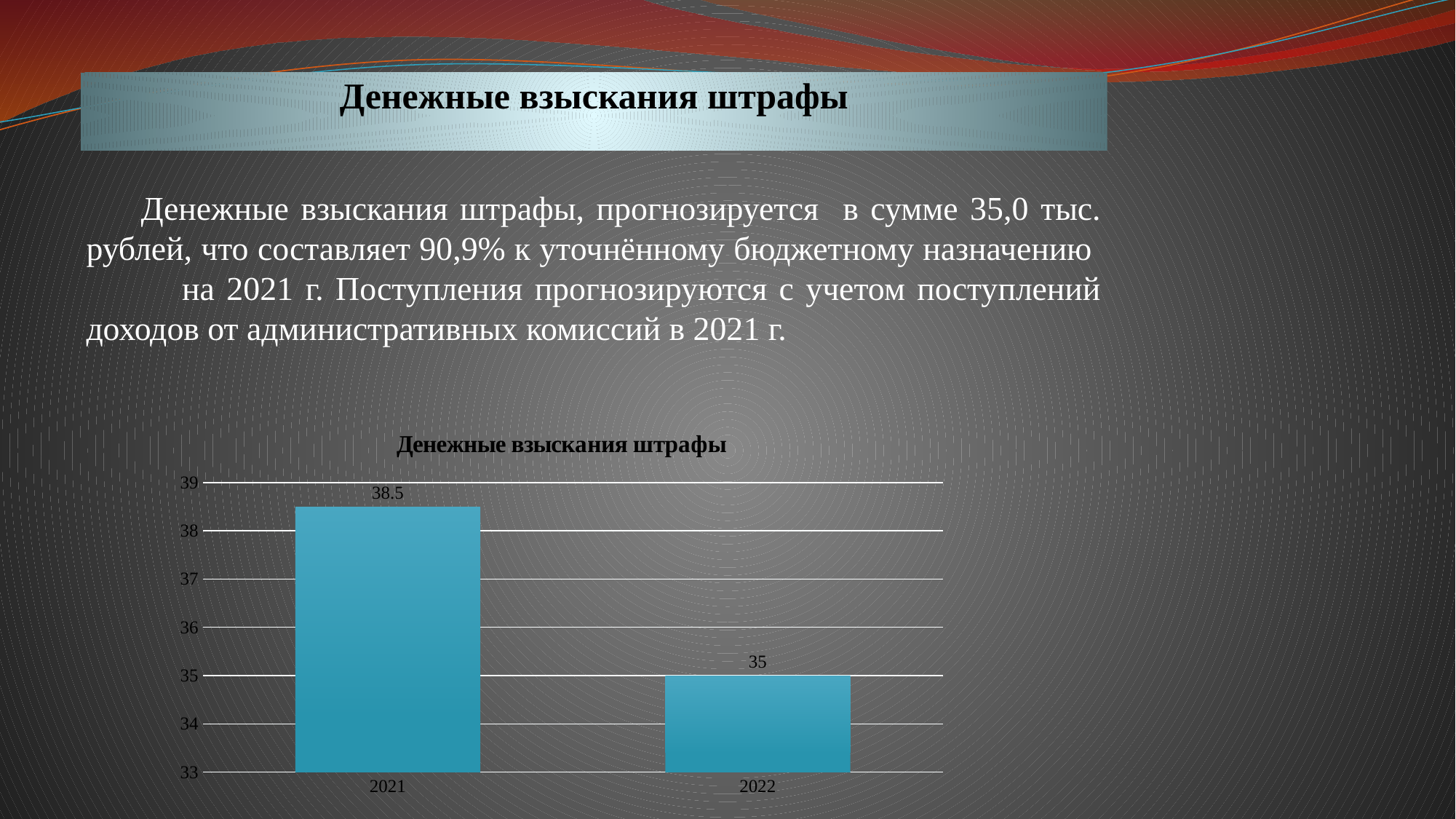
What is the value for 2022? 35 What kind of chart is shown on the slide? bar chart What is the difference between the values for 2021 and 2022? 3.5 What is the value for 2021? 38.5 Do the values rise or fall from 2021 to 2022? fall Is the value for 2021 greater or less than 38? greater Is the value for 2022 greater or less than 36? less How many categories are shown on the x axis? 2 Which year has the highest value? 2021 Which year has the lowest value? 2022 What is the title of the chart? Денежные взыскания штрафы Which is larger, the value for 2021 or the value for 2022? 2021